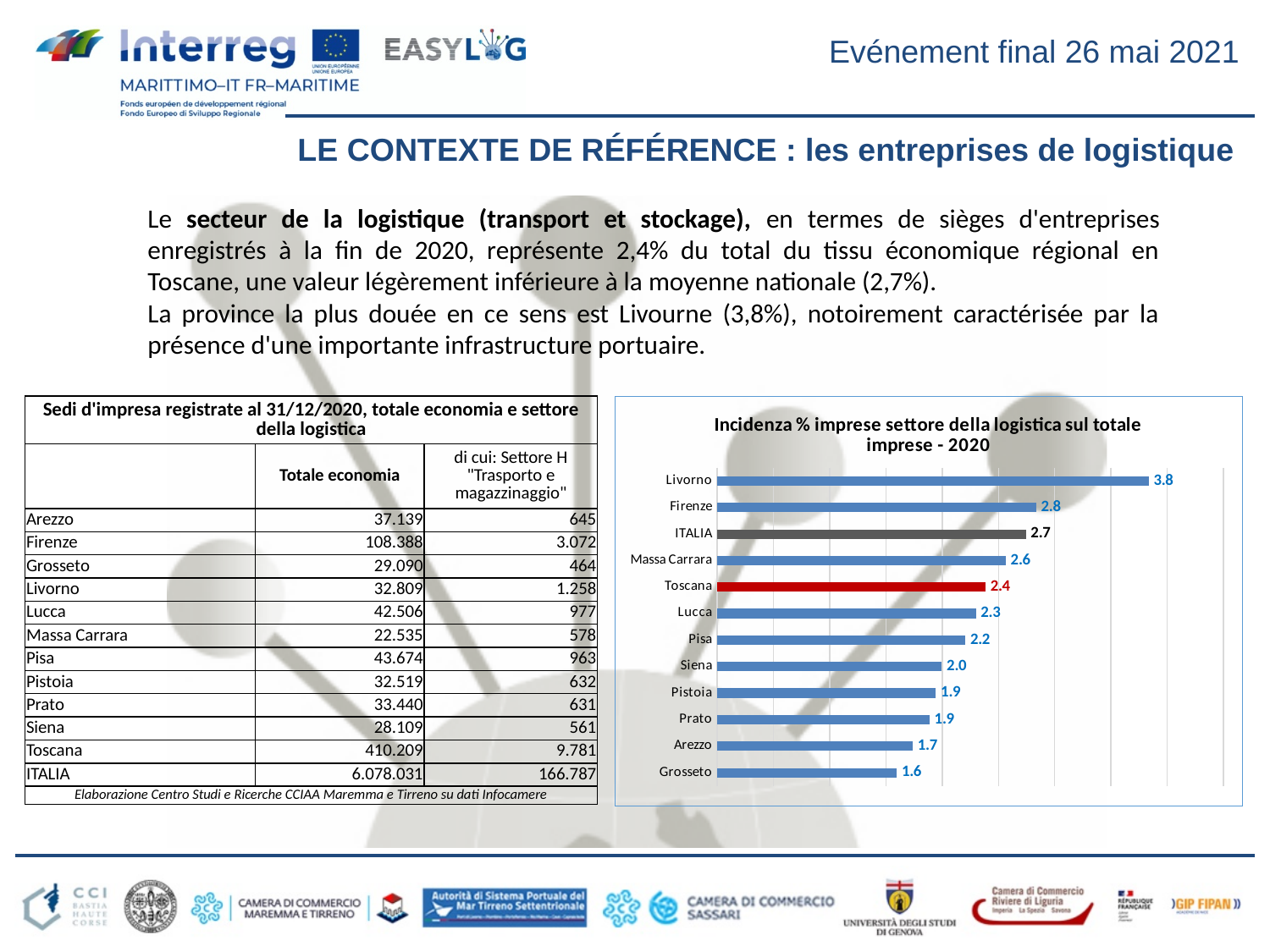
What is the value for ITALIA in the chart? 2.7 Which category's bar is coloured red in the chart? Toscana How many categories are shown in the chart? 12 Which category has the lowest value in the chart? Grosseto What is the difference between the values for Livorno and Grosseto? 2.2 What is the value for Toscana in the chart? 2.4 What is the value for Livorno in the chart? 3.8 What type of chart is shown on the slide? bar chart What is the difference between the values for ITALIA and Toscana? 0.3 What is the value for Massa Carrara in the chart? 2.6 Which has a larger value, Firenze or Lucca? Firenze Which category has the highest value in the chart? Livorno